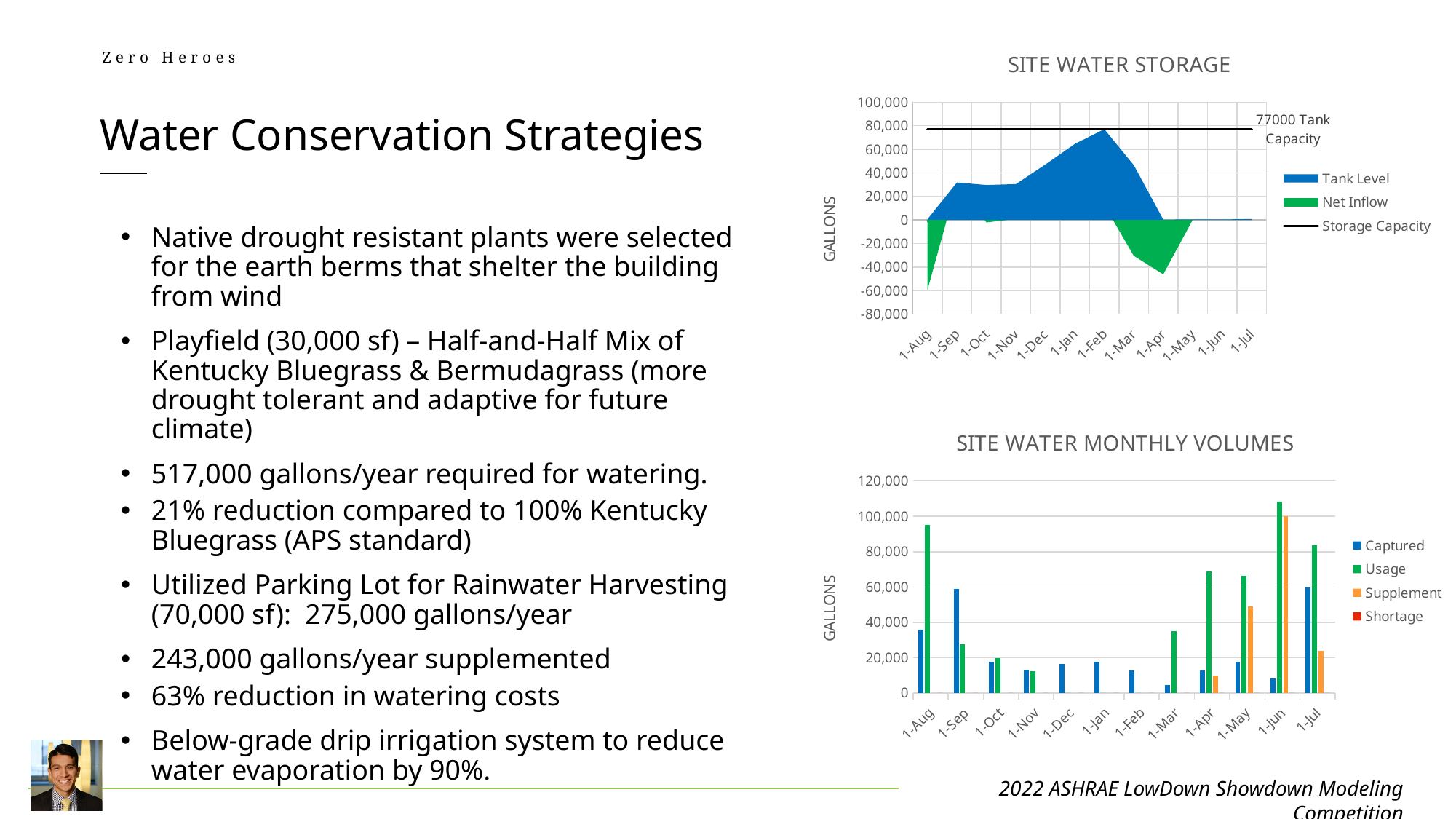
How many series does the legend of the SITE WATER STORAGE chart list? 3 In the SITE WATER MONTHLY VOLUMES chart, is the Usage value for 1-Aug greater or less than 80,000? greater In the SITE WATER MONTHLY VOLUMES chart, is the Captured value for 1-Sep greater or less than 40,000? greater What is the y-axis label of the SITE WATER STORAGE chart? GALLONS In the SITE WATER STORAGE chart, is the Tank Level at 1-Feb greater or less than 60,000? greater How many series does the legend of the SITE WATER MONTHLY VOLUMES chart list? 4 What storage capacity value is labelled on the SITE WATER STORAGE chart? 77000 Tank Capacity How many months are shown on the x axis of the SITE WATER MONTHLY VOLUMES chart? 12 In the SITE WATER MONTHLY VOLUMES chart, which is larger for 1-Aug, Captured or Usage? Usage In the SITE WATER MONTHLY VOLUMES chart, which month has the highest Usage? 1-Jun What type of chart is the SITE WATER MONTHLY VOLUMES chart? bar chart